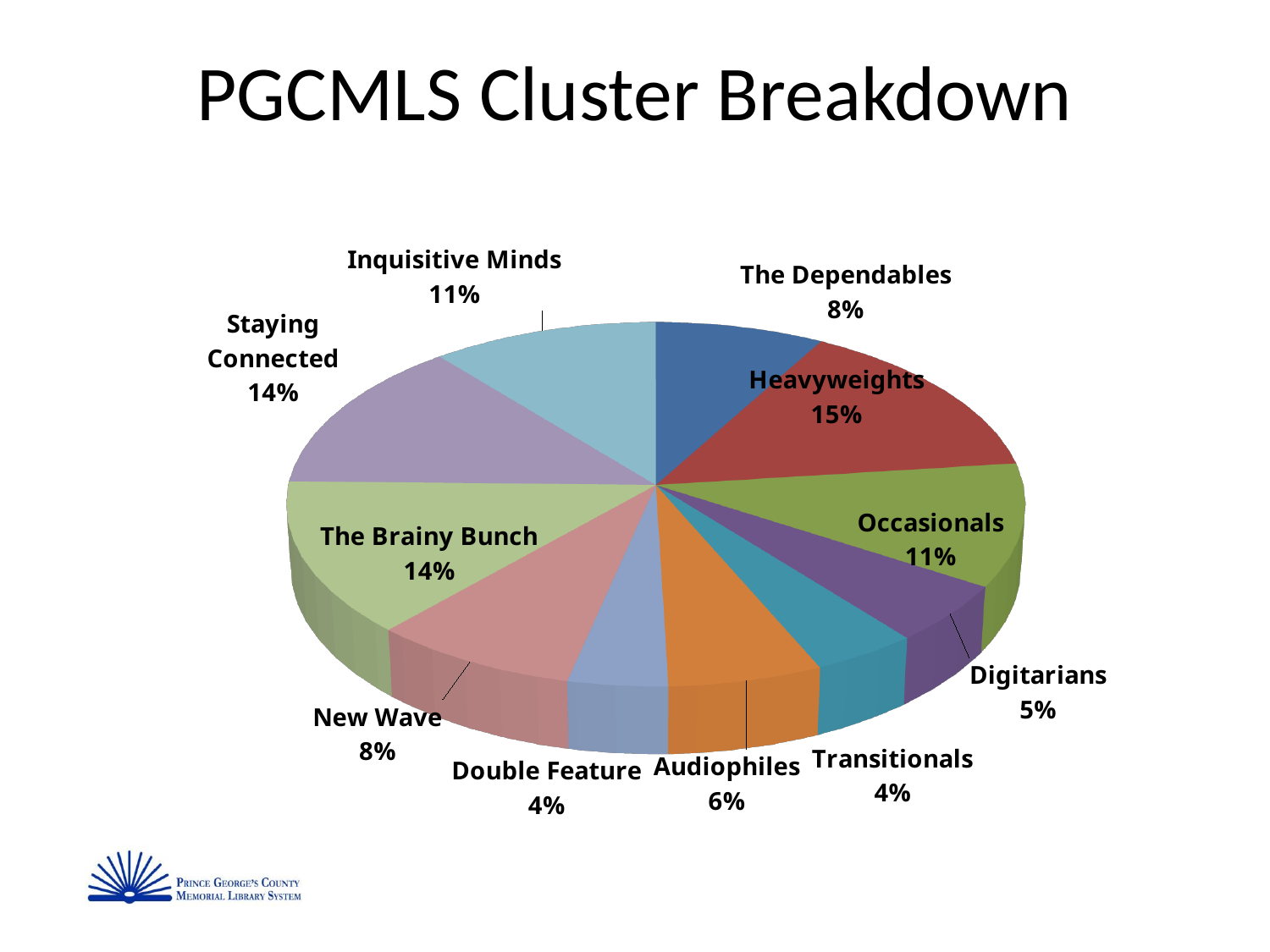
Which is larger, the share for Occasionals or the share for New Wave? Occasionals How many clusters (slices) are shown in the pie chart? 11 What is the title of the chart on the slide? PGCMLS Cluster Breakdown What share of the pie does Heavyweights represent? 15% What is the difference in percentage points between Heavyweights and The Dependables? 7 What percentage is shown for Staying Connected? 14% What is the combined share of The Brainy Bunch and Staying Connected? 28% Which cluster has the largest share of the pie? Heavyweights What percentage is labelled for Audiophiles? 6% What share of the pie does Inquisitive Minds represent? 11% What type of chart is shown on the slide? Pie chart What is the value for Digitarians? 5%